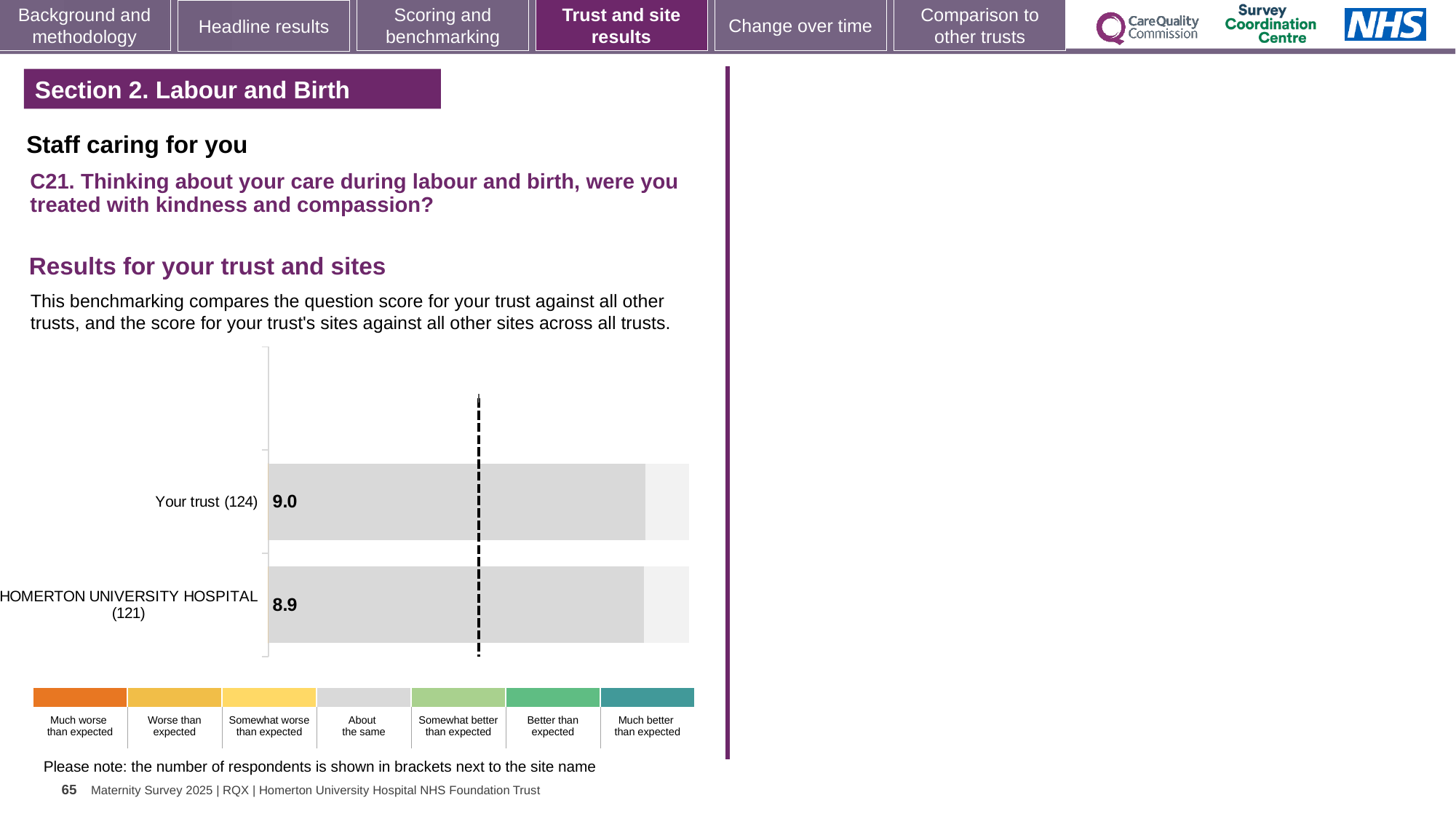
How many benchmark categories does the colour key below the chart list? 7 What is the score for HOMERTON UNIVERSITY HOSPITAL (121)? 8.9 How many respondents are shown in brackets for HOMERTON UNIVERSITY HOSPITAL? 121 How many bars are plotted on the chart? 2 Which category has the lowest score on the chart? HOMERTON UNIVERSITY HOSPITAL (121) What is the difference between the score for Your trust (124) and the score for HOMERTON UNIVERSITY HOSPITAL (121)? 0.1 What kind of chart is shown on the slide? Bar chart How many respondents are shown in brackets for Your trust? 124 Which category has the higher score, Your trust (124) or HOMERTON UNIVERSITY HOSPITAL (121)? Your trust (124) What is the score for Your trust (124)? 9.0 Which benchmark category from the colour key do the grey bars on the chart correspond to? About the same